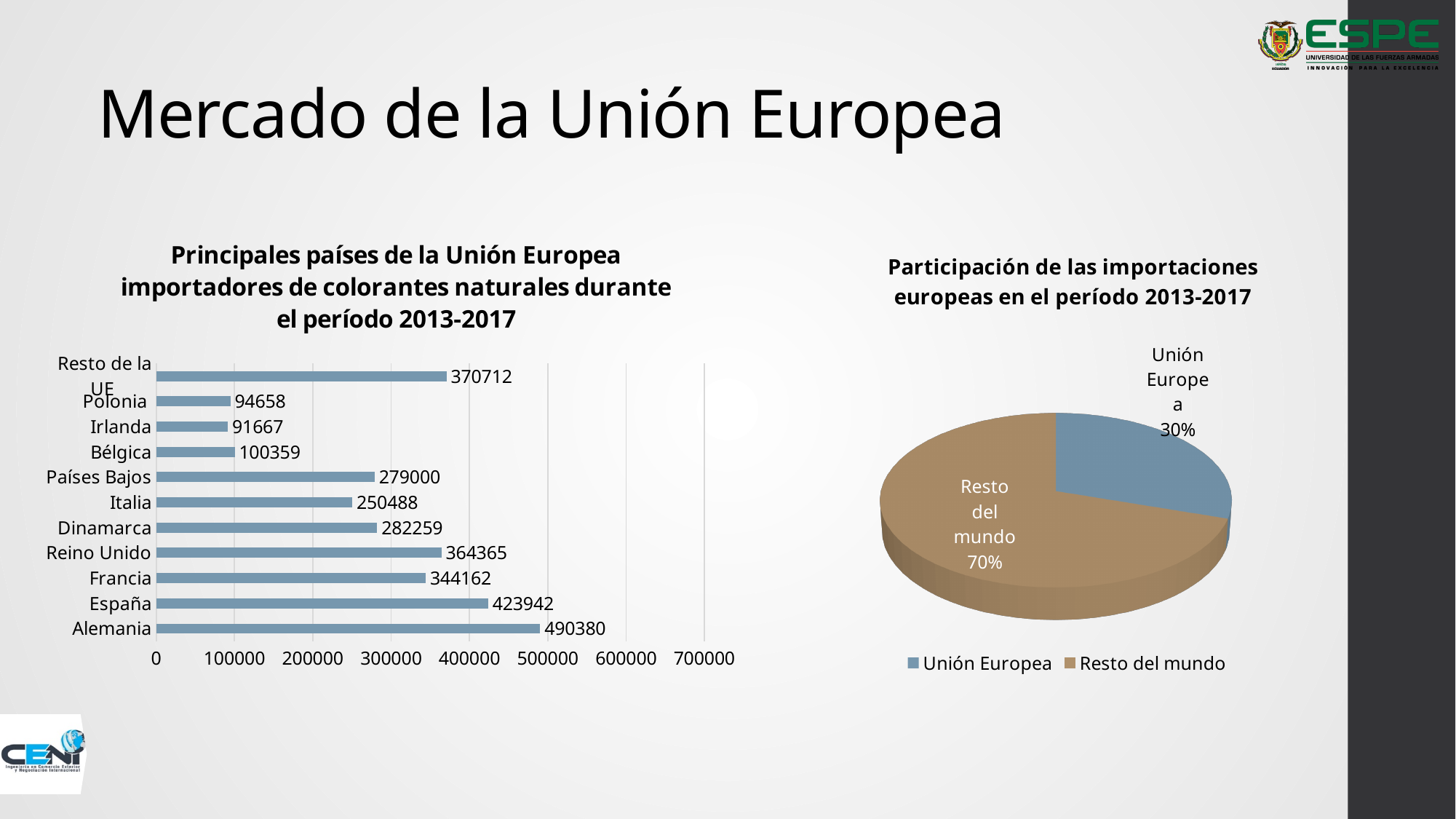
In the bar chart on the left, what is the value for Alemania? 490380 How many categories are shown in the bar chart on the left? 11 How many entries does the legend of the pie chart on the right list? 2 In the bar chart on the left, which country has the highest value? Alemania In the bar chart on the left, which is larger, the value for Dinamarca or the value for Italia? Dinamarca In the bar chart on the left, what is the difference between the values for España and Francia? 79780 In the pie chart on the right, what share does Unión Europea have? 30% In the bar chart on the left, what is the value for Países Bajos? 279000 In the bar chart on the left, which category has the lowest value? Irlanda What kind of chart is the chart on the left? bar chart In the bar chart on the left, is the value for Reino Unido greater or less than 300000? greater In the pie chart on the right, which slice is larger, Unión Europea or Resto del mundo? Resto del mundo